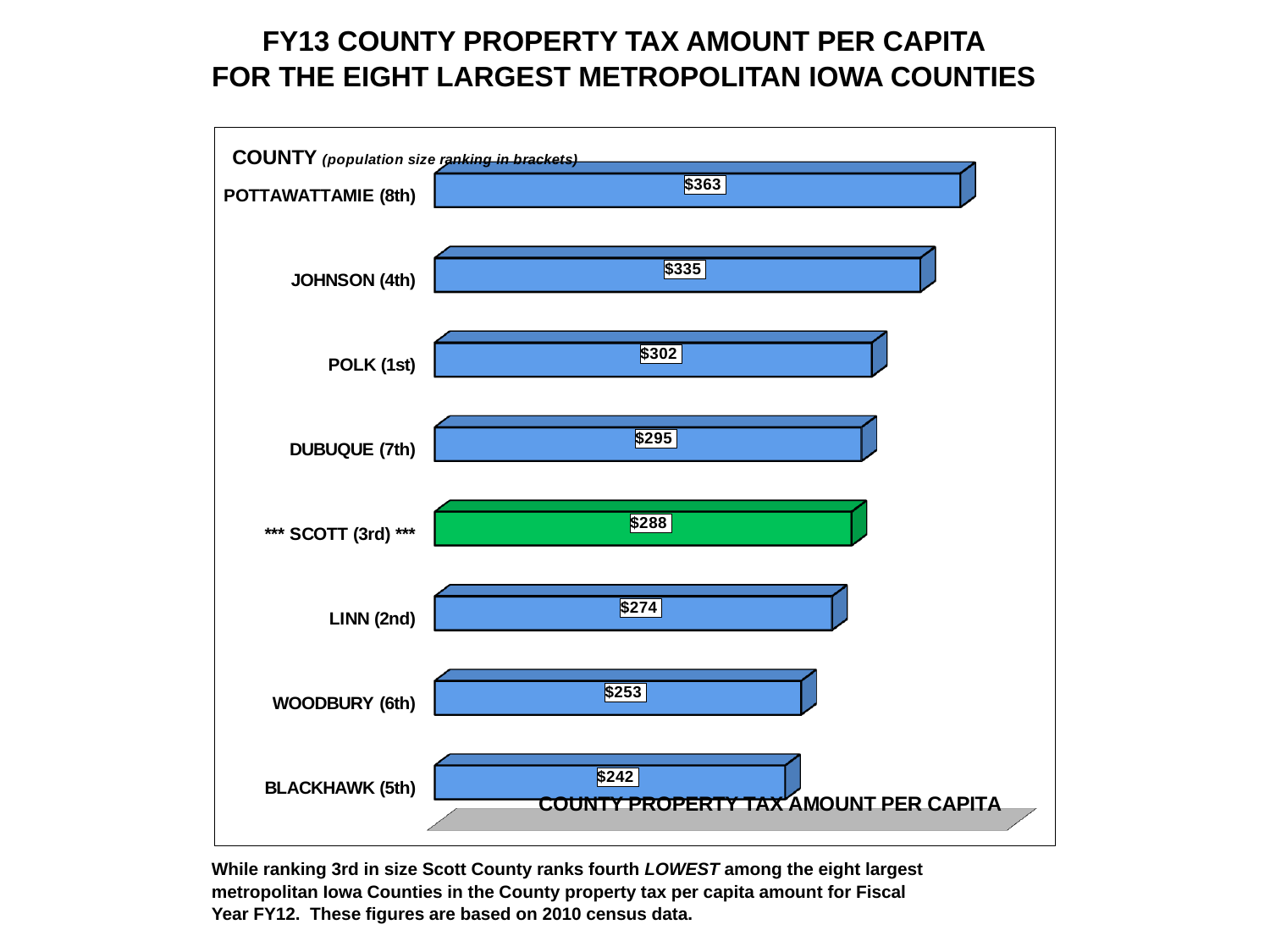
What population size ranking is shown in brackets for Polk County? 1st What is the county property tax amount per capita for Scott County? $288 How many counties are shown in the chart? 8 What is the difference between the per capita amounts for Pottawattamie and Blackhawk counties? $121 What is the difference between the per capita amounts for Polk and Dubuque counties? $7 Which county's bar is coloured green instead of blue? Scott Which has a higher property tax amount per capita, Linn County or Dubuque County? Dubuque What kind of chart is shown on the slide? Bar chart What is the county property tax amount per capita for Johnson County? $335 What is the county property tax amount per capita for Woodbury County? $253 Which county has the highest property tax amount per capita? Pottawattamie Which county has the lowest property tax amount per capita? Blackhawk